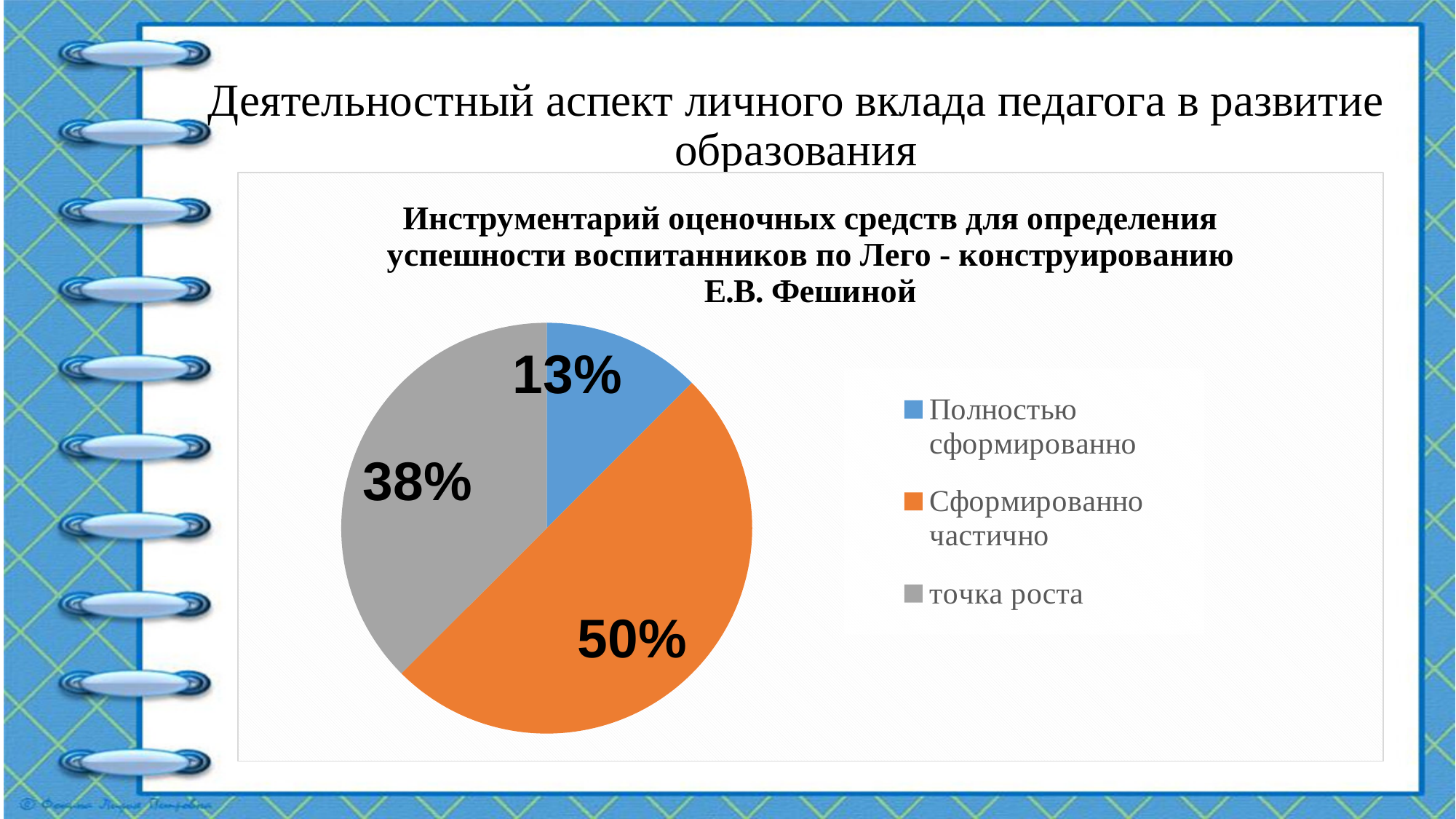
Which category has the largest slice of the pie? Сформированно частично What is the difference in percentage points between "Сформированно частично" and "точка роста"? 12 What kind of chart is shown on the slide? pie chart How many entries does the legend list? 3 What is the difference in percentage points between "точка роста" and "Полностью сформированно"? 25 Which is larger: the slice for "точка роста" or the slice for "Полностью сформированно"? точка роста What share of the pie is labelled "Сформированно частично"? 50% What share of the pie is labelled "точка роста"? 38% Which category has the smallest slice of the pie? Полностью сформированно What colour is the slice for "точка роста"? grey What share of the pie is labelled "Полностью сформированно"? 13% How many slices does the pie chart have? 3